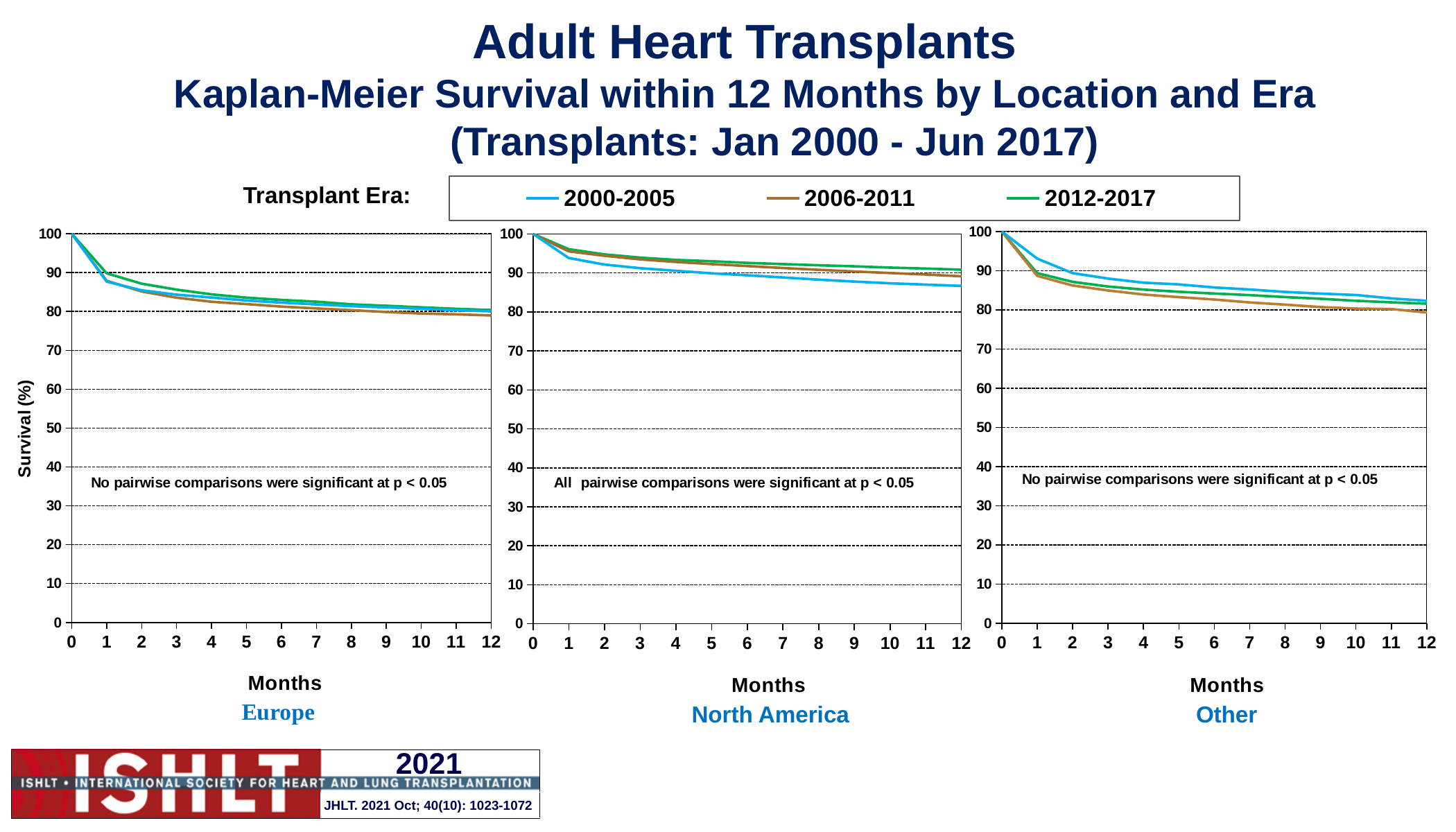
How many transplant eras does the legend list? 3 In the North America chart, which era has the lowest survival at 12 months? 2000-2005 In the North America chart, is the survival for 2000-2005 at 12 months greater or less than 90? less In the Europe chart, is the survival for 2006-2011 at 12 months greater or less than 70? greater Which transplant eras are listed in the legend? 2000-2005, 2006-2011, 2012-2017 How many location panels (charts) are shown on the slide? 3 In the Other chart, at 6 months, which era has higher survival: 2000-2005 or 2006-2011? 2000-2005 In the North America chart, is the survival for 2012-2017 at 12 months greater or less than 80? greater What type of chart is used in the Europe panel? line chart In the North America chart, what is the survival value for all eras at month 0? 100 In the North America chart, which era has the highest survival at 12 months? 2012-2017 Which location panel states that all pairwise comparisons were significant at p < 0.05? North America